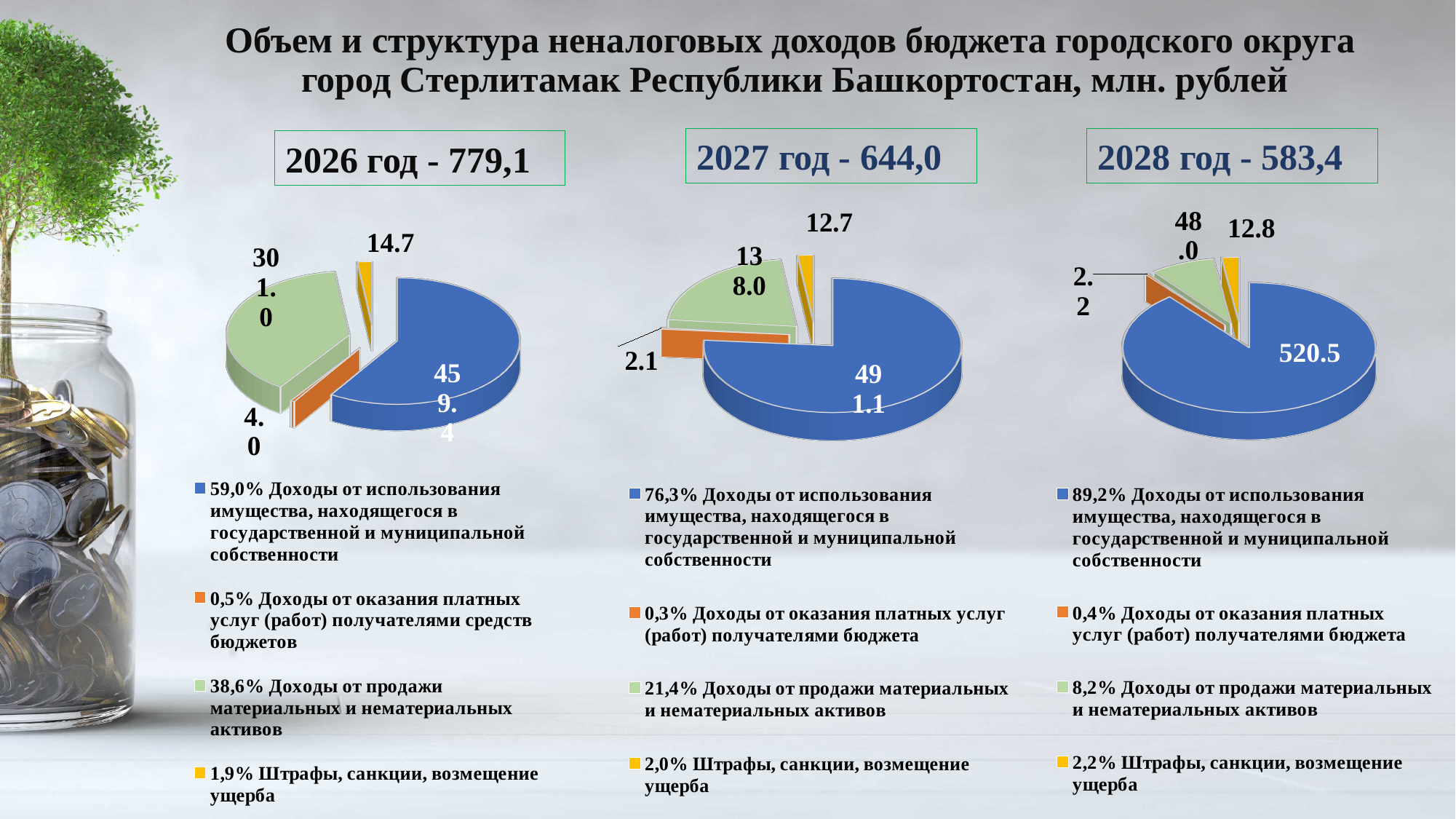
How many categories does the legend of the 2026 chart list? 4 In the 2028 chart, which category has the largest slice? Доходы от использования имущества, находящегося в государственной и муниципальной собственности In the 2027 chart, what is the value for Штрафы, санкции, возмещение ущерба? 12.7 In the 2028 chart, what share of the pie is Доходы от продажи материальных и нематериальных активов? 8,2% Which is larger: the value for Штрафы, санкции, возмещение ущерба in the 2026 chart or in the 2027 chart? 2026 In the 2027 chart, what share of the pie is Доходы от использования имущества, находящегося в государственной и муниципальной собственности? 76,3% What kind of chart is used for each of the three years on the slide? Pie chart In the 2026 chart, what is the value for Штрафы, санкции, возмещение ущерба? 14.7 In the 2026 chart, what is the value for Доходы от оказания платных услуг (работ) получателями средств бюджетов? 4.0 In the 2027 chart, which category has the smallest slice? Доходы от оказания платных услуг (работ) получателями бюджета What is the difference between the value for Штрафы, санкции, возмещение ущерба in the 2028 chart and in the 2027 chart? 0.1 In the 2028 chart, what is the value for Доходы от использования имущества, находящегося в государственной и муниципальной собственности? 520.5